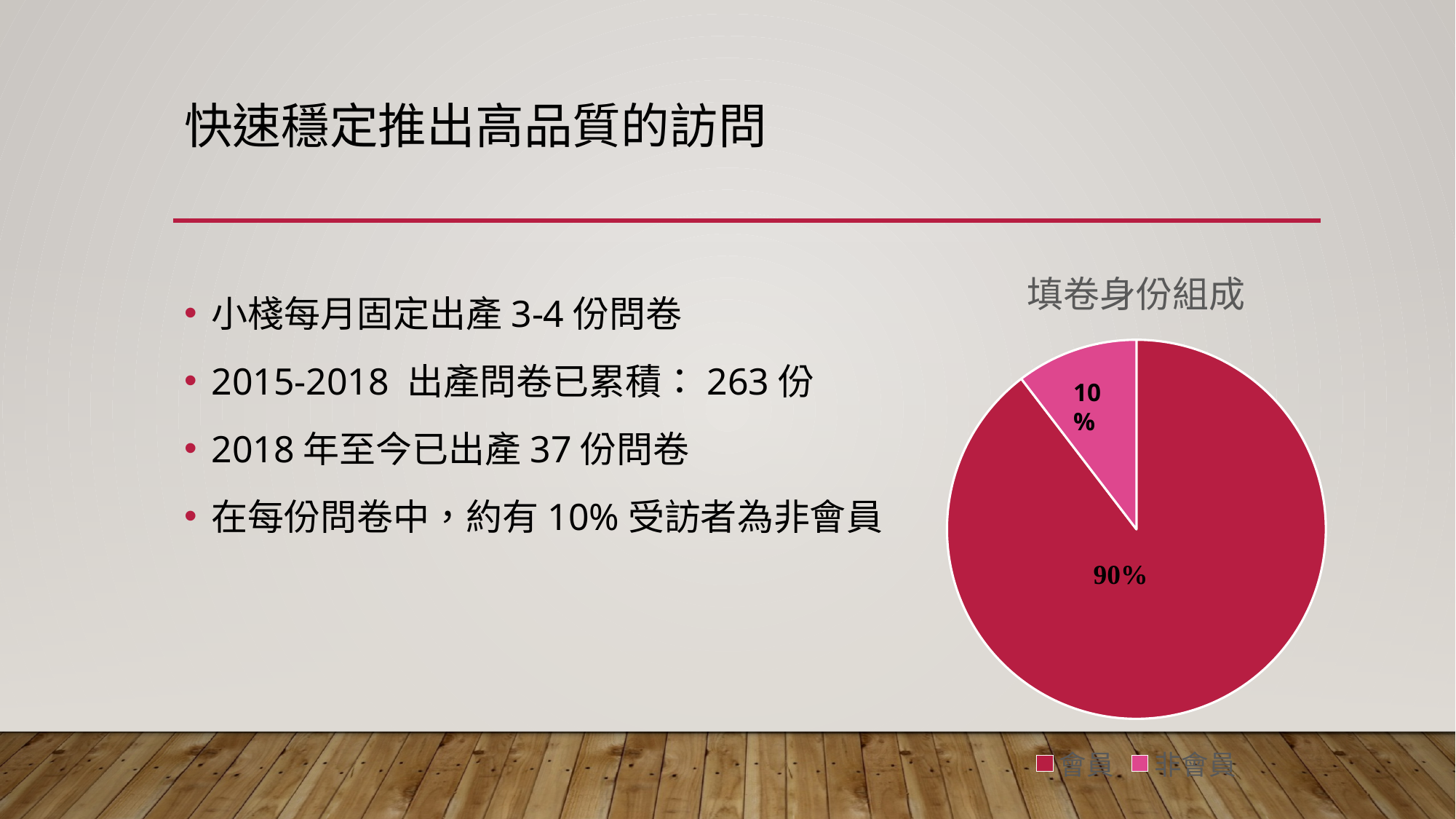
What kind of chart is shown on the slide? pie chart Which slice of the pie is the smallest? 非會員 Which is larger, the share for 會員 or the share for 非會員? 會員 Which legend entry is shown in the lighter pink colour? 非會員 What is the difference between the share for 會員 and the share for 非會員? 80% What share of the pie does 會員 take? 90% How many entries does the legend list? 2 Which slice of the pie is the largest? 會員 What share of the pie does 非會員 take? 10% How many slices does the pie chart have? 2 What is the title of the chart? 填卷身份組成